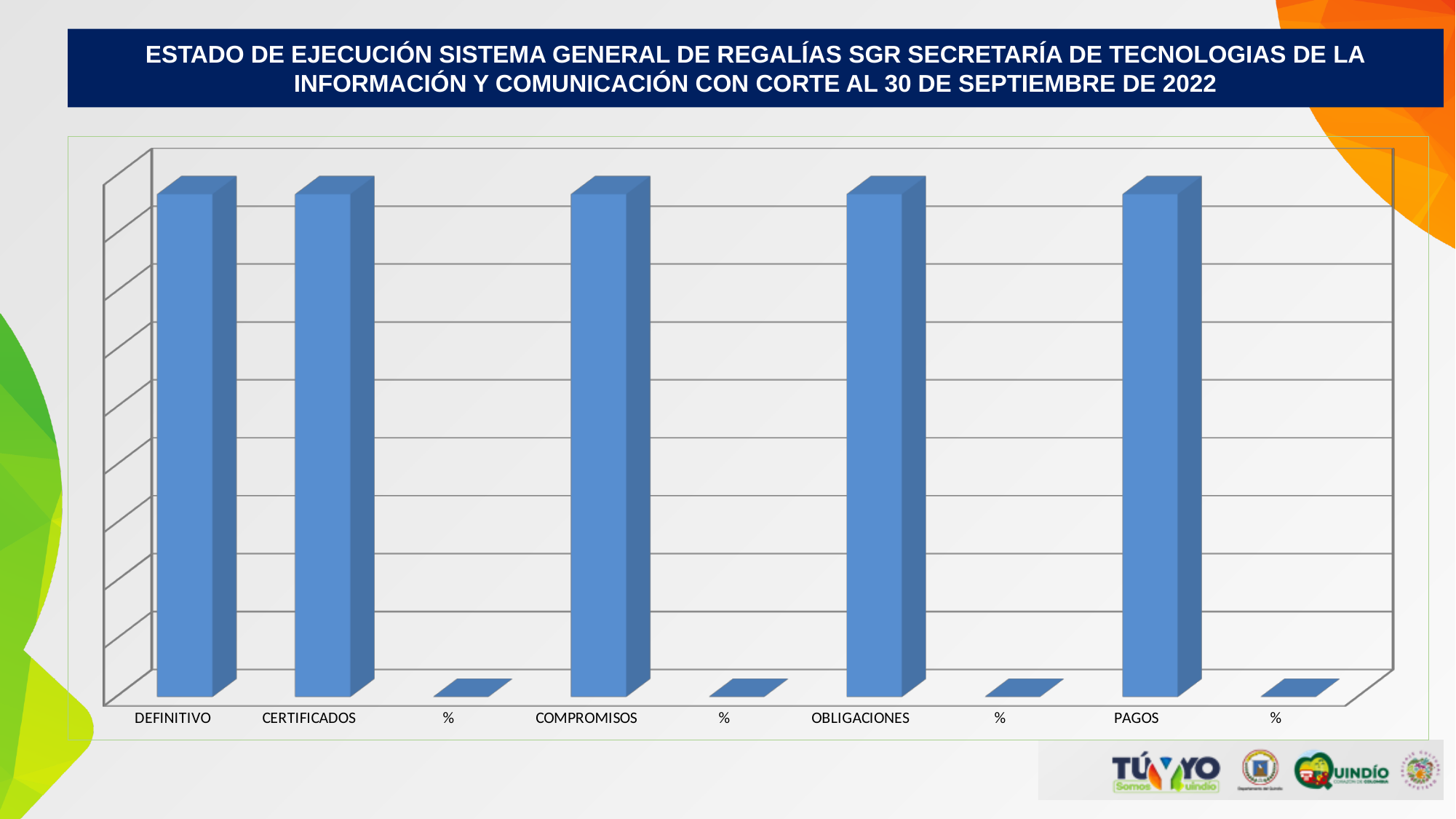
What colour are the bars in the chart? Blue Which is larger, the value for OBLIGACIONES or the value for the % category immediately to its right? OBLIGACIONES How many categories are shown along the x axis of the chart? 9 Which is larger, the value for PAGOS or the value for the last % category on the right? PAGOS What kind of chart is shown on the slide? Bar chart What is the label of the first category on the left of the x axis? DEFINITIVO Which is larger, the value for COMPROMISOS or the value for the % category immediately to its right? COMPROMISOS